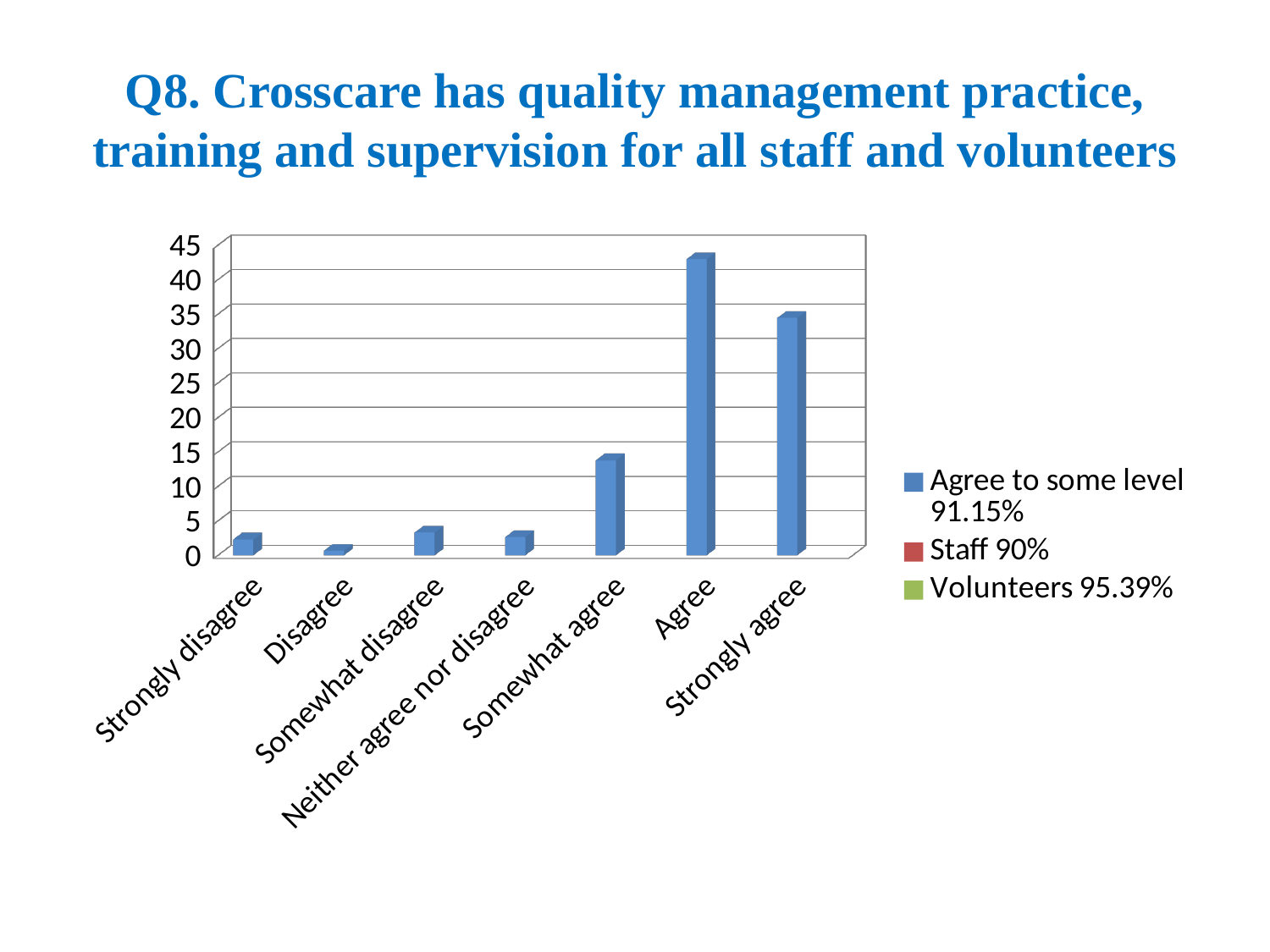
Is the value for Strongly disagree greater or less than 5? less What percentage does the legend give for Volunteers? 95.39% What kind of chart is shown on the slide? Bar chart How many entries does the chart's legend list? 3 Which category has the highest bar in the chart? Agree Is the value for Somewhat agree greater or less than 10? greater Is the value for Agree greater or less than 40? greater Which is larger, the value for Somewhat agree or the value for Somewhat disagree? Somewhat agree Which category has the lowest bar in the chart? Disagree How many categories are shown on the x axis of the chart? 7 Which is larger, the value for Agree or the value for Strongly agree? Agree